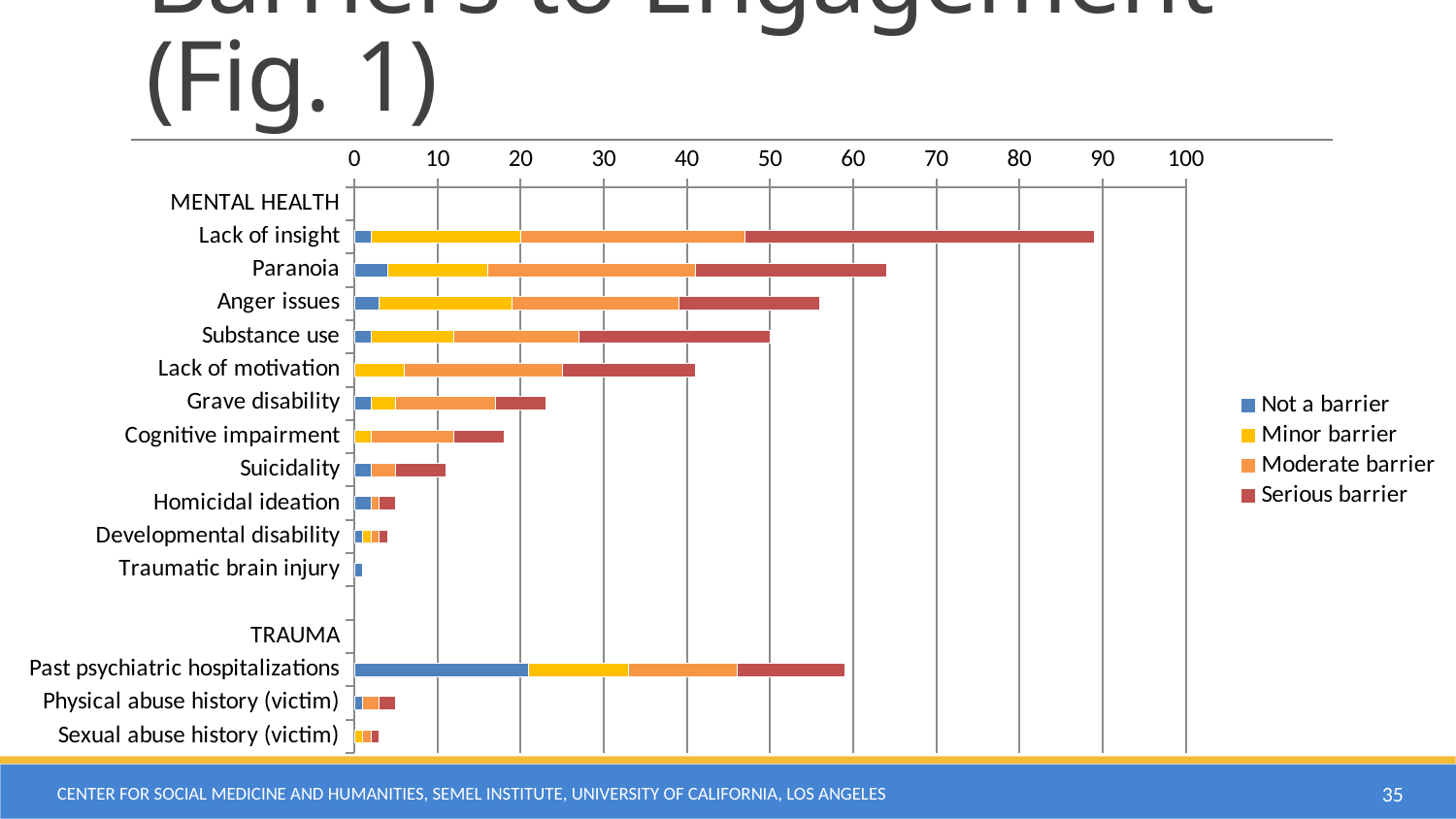
Which legend entry is shown in blue? Not a barrier Is the total bar for Grave disability greater or less than 20? greater Which barrier has the longest total bar? Lack of insight Which has the longer total bar, Paranoia or Anger issues? Paranoia Is the total bar for Traumatic brain injury greater or less than 10? less Is the total bar for Lack of insight greater or less than 80? greater How many series does the legend list? 4 What kind of chart is shown on the slide? Stacked bar chart How many barrier categories are listed under the TRAUMA heading? 3 Which barrier has the shortest total bar? Traumatic brain injury Which has the longer total bar, Past psychiatric hospitalizations or Lack of motivation? Past psychiatric hospitalizations